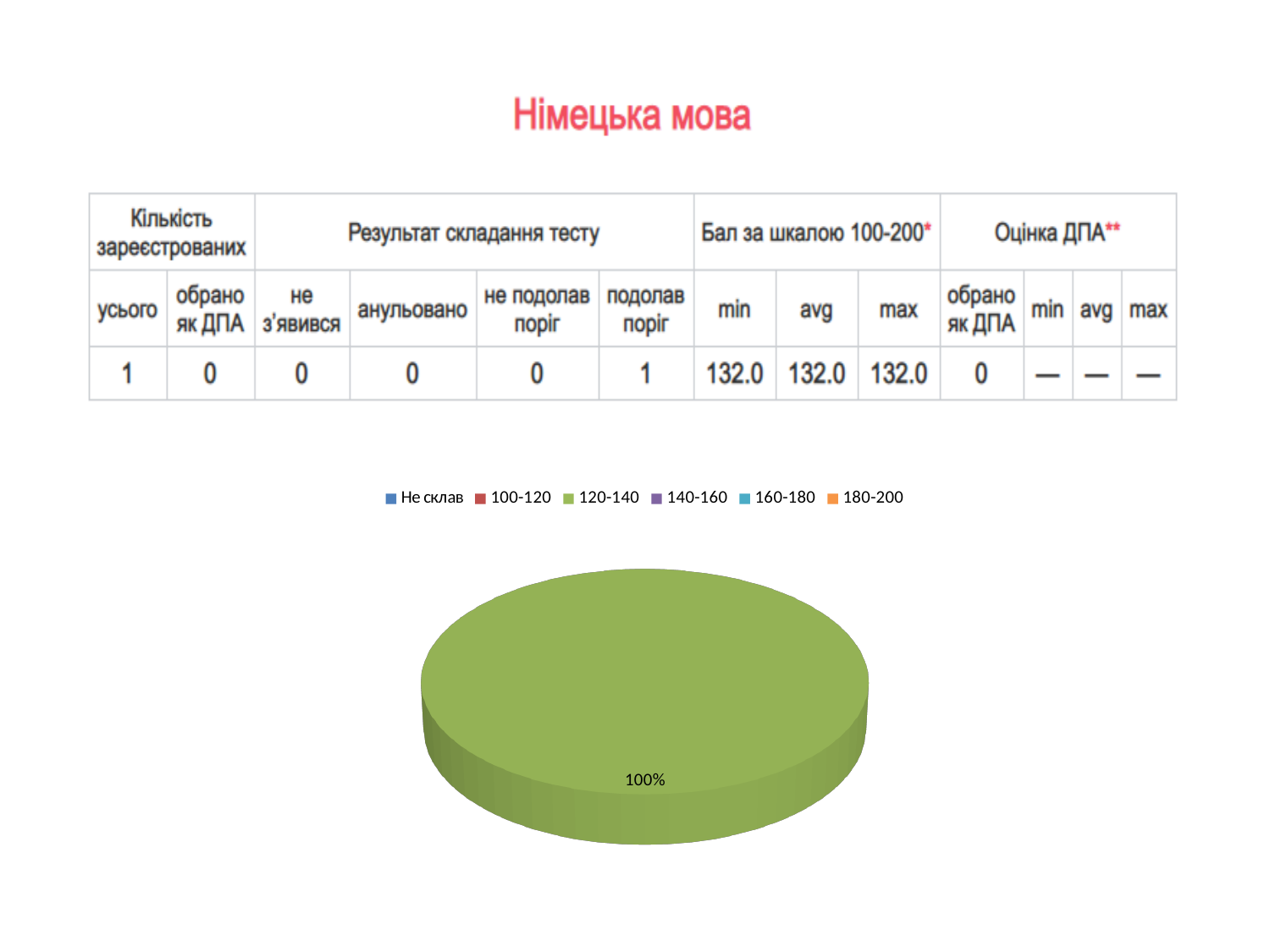
What percentage label is printed on the pie chart? 100% What share of the pie chart does the 120-140 category take? 100% What kind of chart is shown on the slide? pie chart What is the first entry listed in the pie chart legend? Не склав Which category makes up the entire pie chart? 120-140 How many slices are visible in the pie chart? 1 How many entries does the legend of the pie chart list? 6 What colour is the 120-140 category in the pie chart legend? green